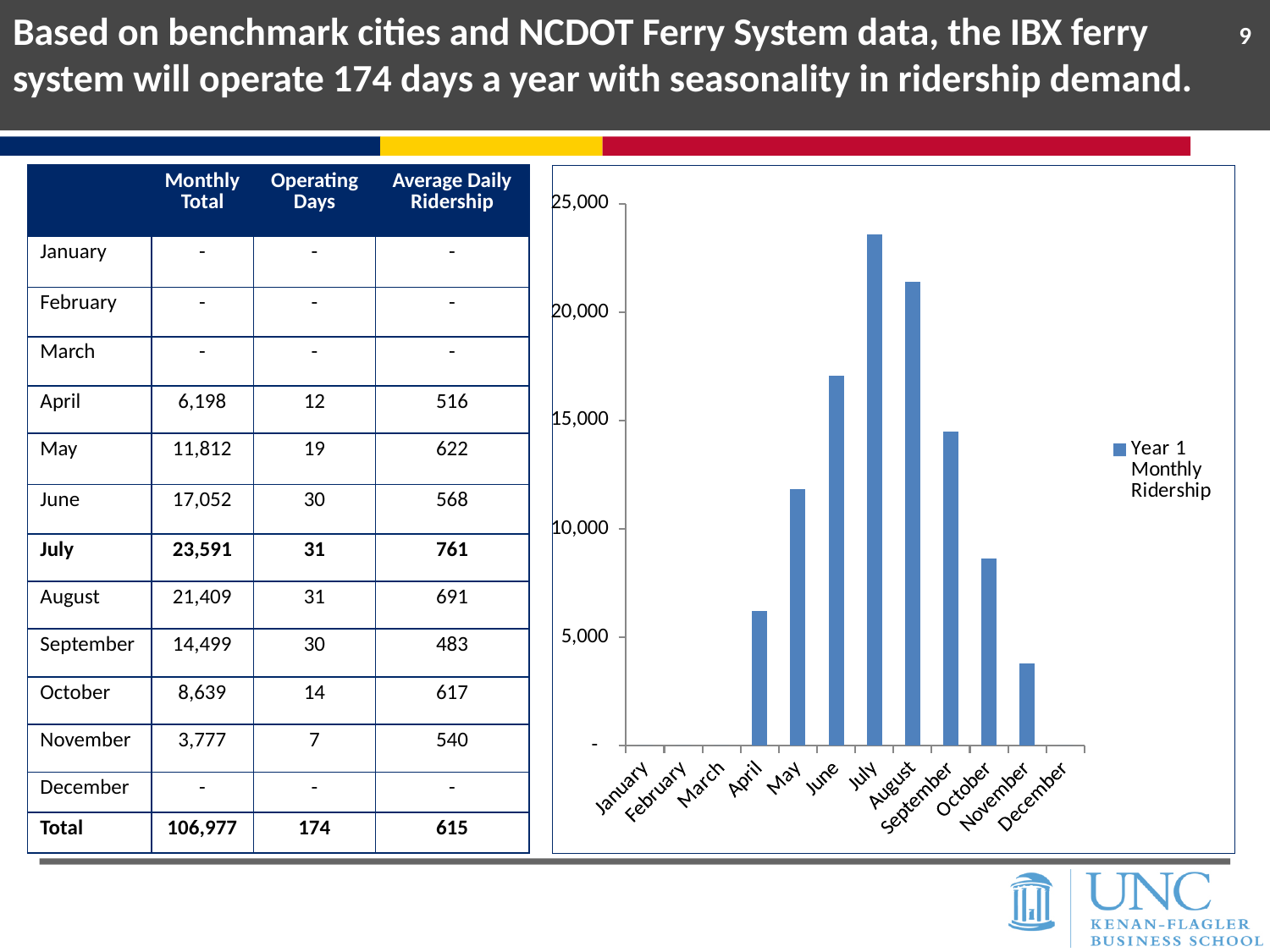
Which month has the highest Year 1 Monthly Ridership in the chart? July Is the value for September in the chart greater or less than 15,000? less What is the Year 1 Monthly Ridership for July, as printed on the slide? 23,591 How many months are shown along the x axis of the chart? 12 Which is larger in the chart, the value for June or the value for October? June What is the name of the series shown in the chart legend? Year 1 Monthly Ridership Do the monthly ridership values rise or fall from April to July in the chart? rise What kind of chart is shown on the slide? bar chart Is the value for July in the chart greater or less than 20,000? greater What is the difference between the monthly ridership for July and August, using the values printed on the slide? 2,182 Is the value for November in the chart greater or less than 5,000? less How many series does the chart's legend list? 1